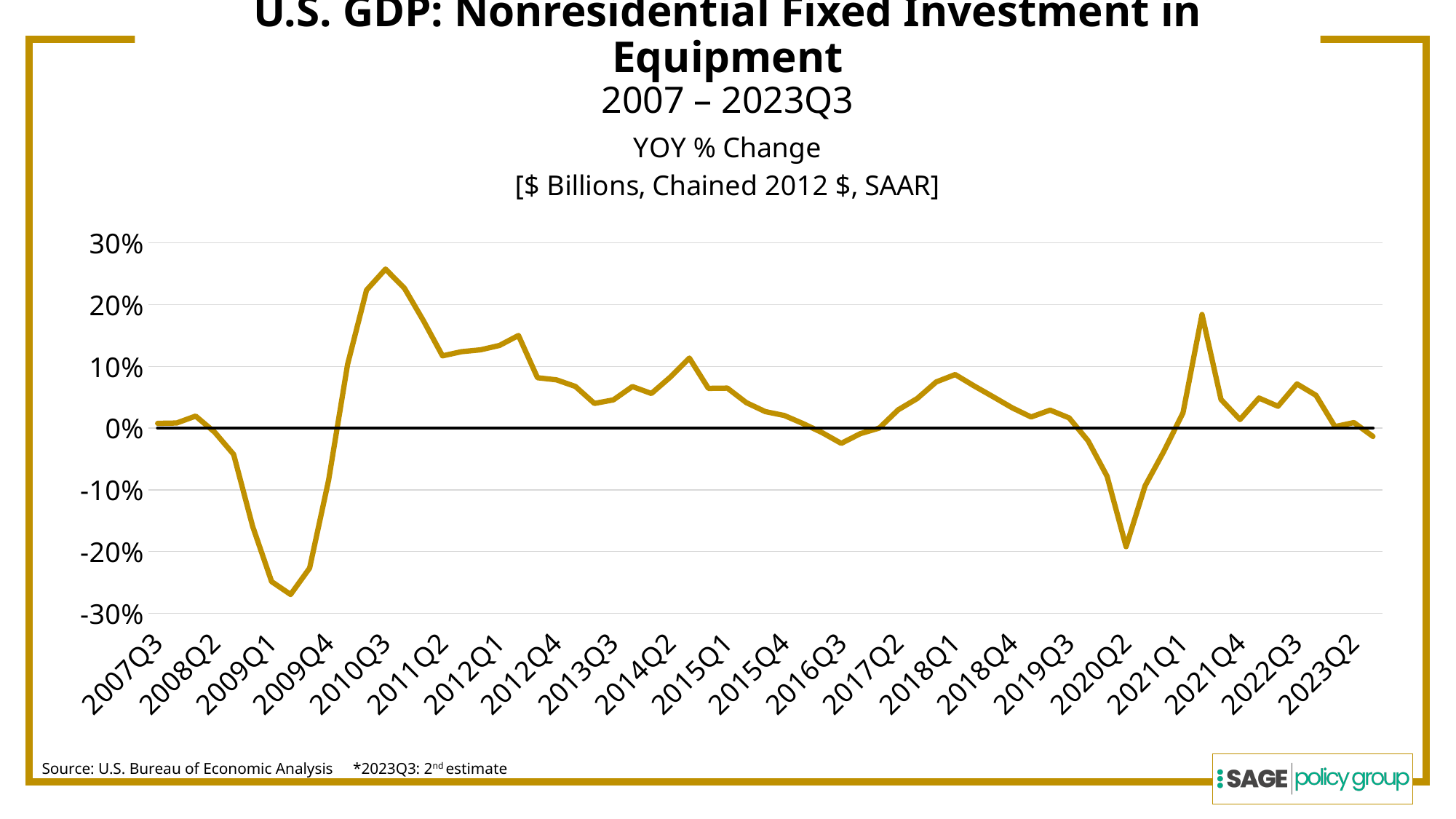
How many data series are plotted on the chart? 1 Is the value for 2020Q2 greater or less than -10%? less What is the title of the chart? U.S. GDP: Nonresidential Fixed Investment in Equipment How many quarter labels are shown on the x axis? 22 What is the source cited for the chart data? U.S. Bureau of Economic Analysis In which year does the line reach its lowest value? 2009 Is the value for 2012Q1 greater or less than 10%? greater Does the line rise or fall between 2009Q1 and 2010Q3? rise Is the value for 2009Q1 greater or less than -10%? less In which year does the line reach its highest value? 2010 What kind of chart is shown on the slide? line chart Which is larger, the value for 2010Q3 or the value for 2020Q2? 2010Q3